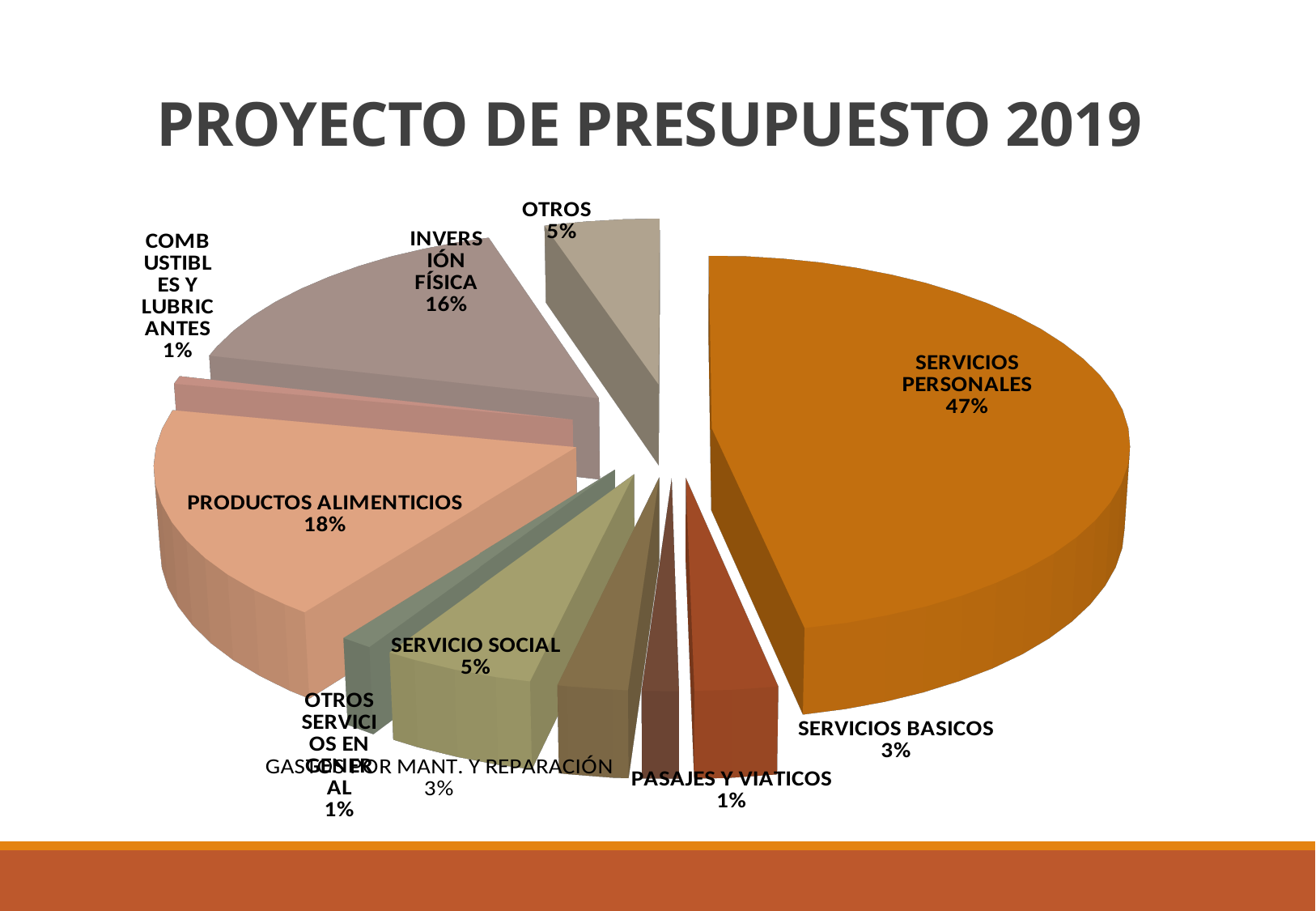
What percentage is shown for SERVICIOS BASICOS? 3% Which category has the largest share of the pie? SERVICIOS PERSONALES What kind of chart is shown on the slide? Pie chart What share of the pie does SERVICIOS PERSONALES represent? 47% Which is larger, the share for PRODUCTOS ALIMENTICIOS or the share for INVERSIÓN FÍSICA? PRODUCTOS ALIMENTICIOS What percentage is shown for PRODUCTOS ALIMENTICIOS? 18% How many slices does the pie chart have? 10 What is the combined share of OTROS and SERVICIO SOCIAL? 10% What is the difference in percentage points between SERVICIOS PERSONALES and PRODUCTOS ALIMENTICIOS? 29 What percentage is shown for PASAJES Y VIATICOS? 1% What is the title of the chart? PROYECTO DE PRESUPUESTO 2019 What percentage is shown for INVERSIÓN FÍSICA? 16%